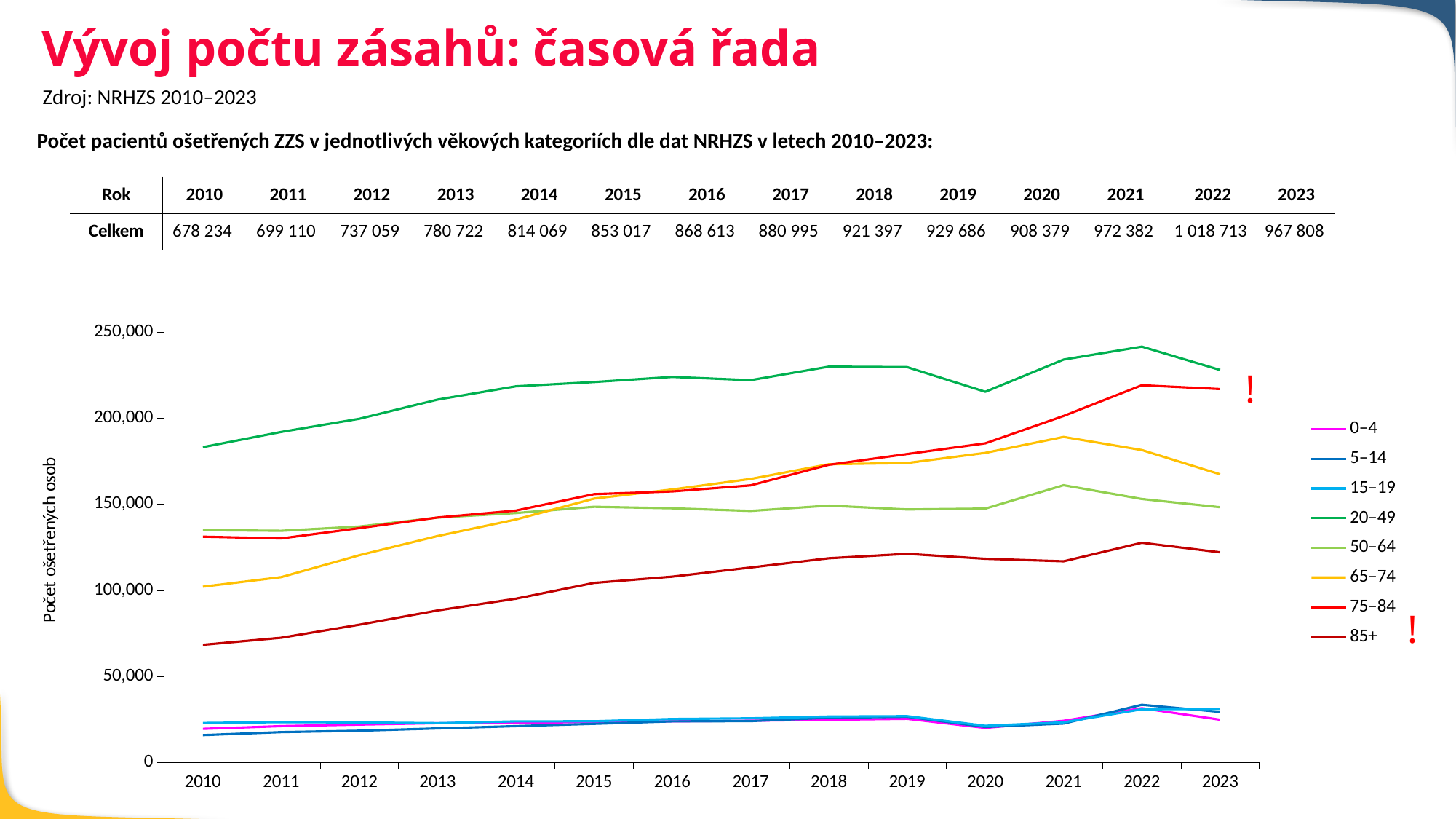
What kind of chart is shown on the slide? line chart Does the value for the 85+ category rise or fall from 2010 to 2022? rise In 2023, which is larger: the value for 75–84 or the value for 50–64? 75–84 Which age category has the lowest value in 2010? 5–14 How many series does the chart legend list? 8 Is the value for the 65–74 category in 2021 greater or less than 150,000? greater Is the value for the 20–49 category in 2022 greater or less than 200,000? greater Which age category has the highest value in 2023? 20–49 How many years are plotted along the x axis of the chart? 14 Is the value for the 75–84 category in 2010 greater or less than 150,000? less What is the label of the chart's y axis? Počet ošetřených osob